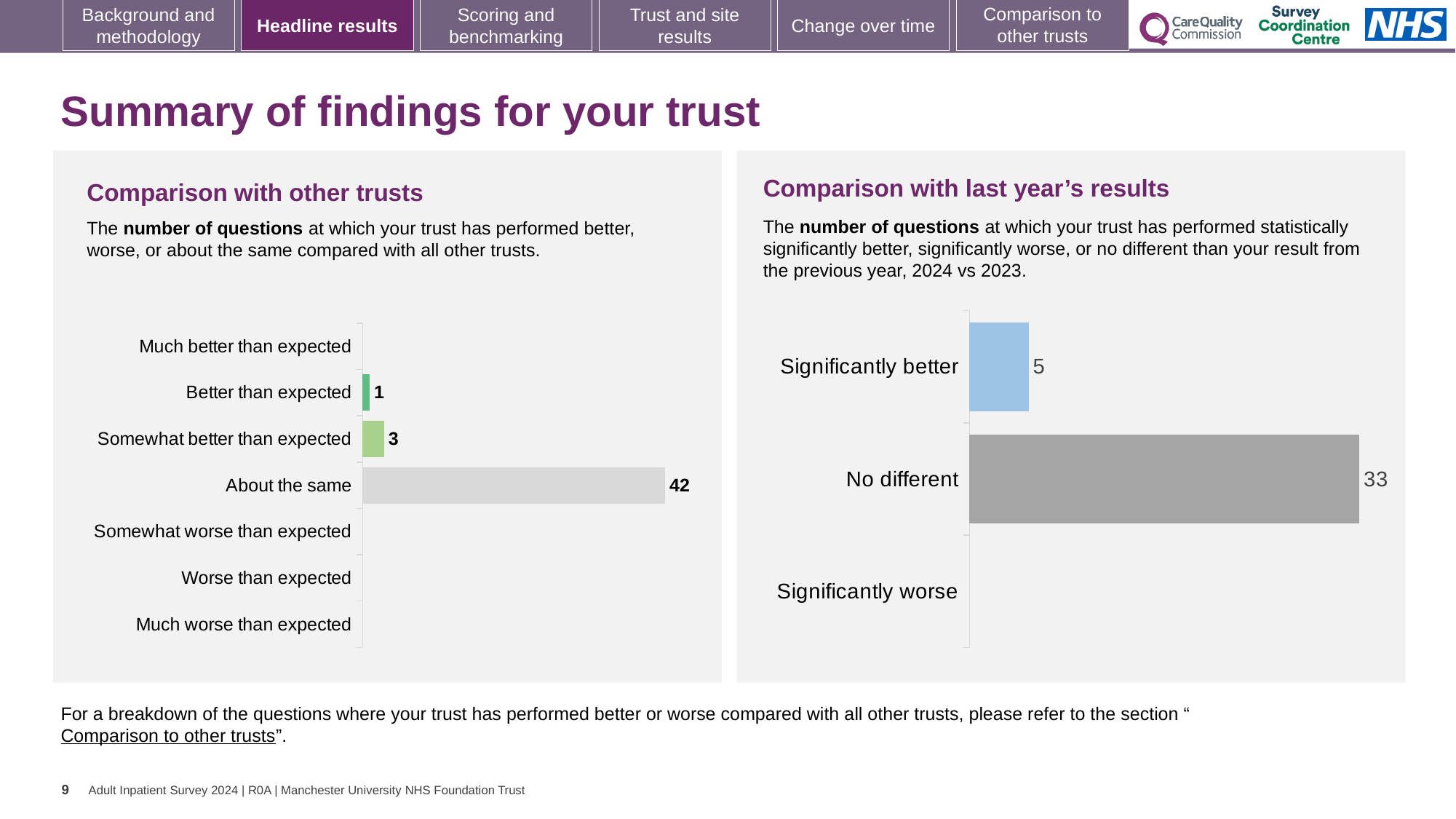
In the 'Comparison with last year's results' chart, how many questions are 'Significantly better'? 5 In the 'Comparison with other trusts' chart, how many questions are 'About the same'? 42 In the 'Comparison with other trusts' chart, how many questions are 'Somewhat better than expected'? 3 In the 'Comparison with other trusts' chart, how many questions are 'Better than expected'? 1 In the 'Comparison with other trusts' chart, which category has the highest number of questions? About the same In the 'Comparison with other trusts' chart, what is the difference between 'About the same' and 'Somewhat better than expected'? 39 In the 'Comparison with last year's results' chart, how many questions are 'No different'? 33 In the 'Comparison with last year's results' chart, which category has the largest value? No different In the 'Comparison with other trusts' chart, how many categories are listed on the axis? 7 In the 'Comparison with last year's results' chart, what is the difference between 'No different' and 'Significantly better'? 28 In the 'Comparison with last year's results' chart, how many categories are shown? 3 What type of chart is the 'Comparison with last year's results' chart? Bar chart